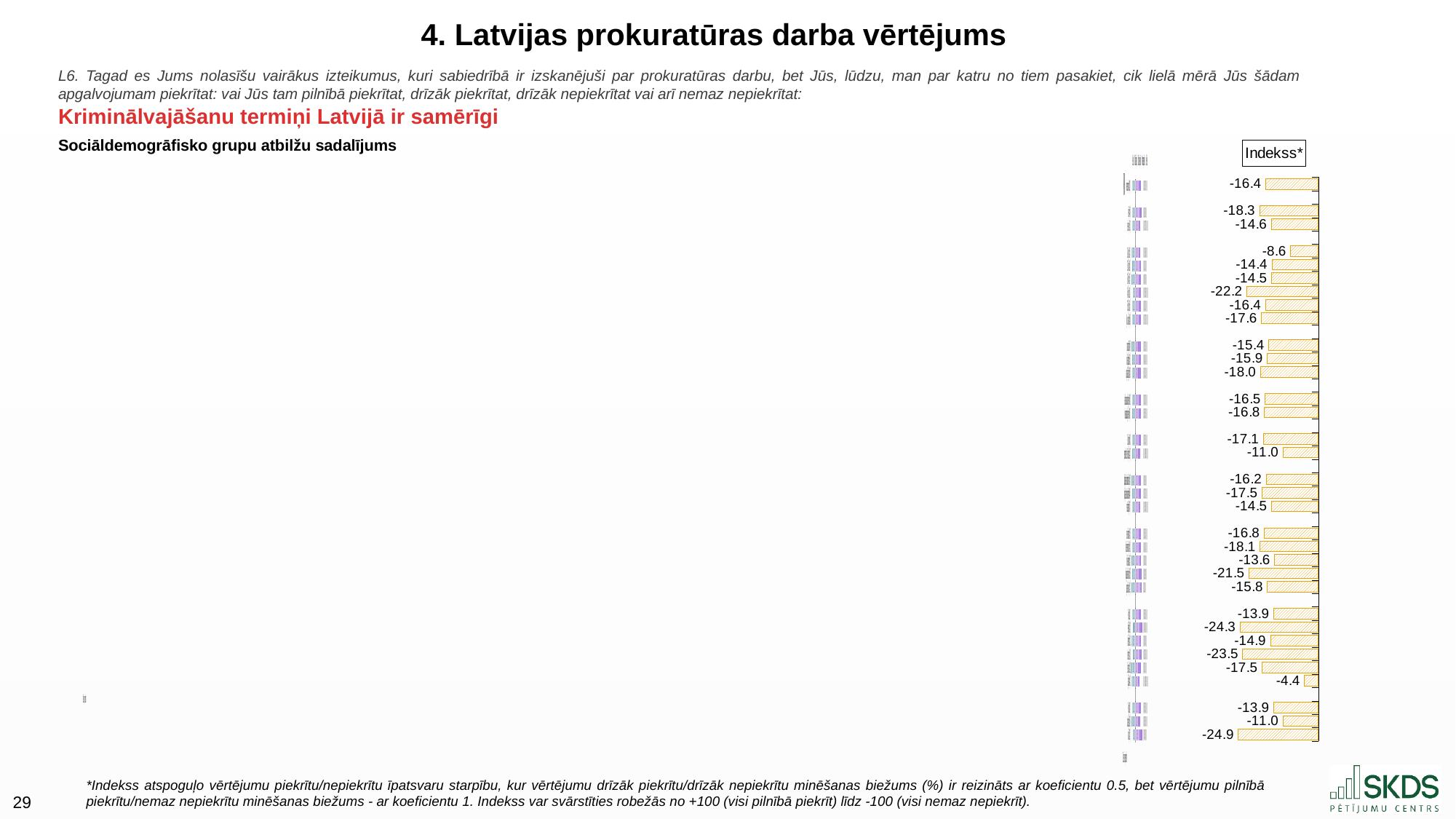
In the Indekss* chart, what is the value of the topmost bar? -16.4 In the Indekss* chart, what is the value of the bottommost bar? -24.9 In the Indekss* chart, which is larger: the value of the topmost bar (-16.4) or the value of the bottommost bar (-24.9)? the topmost bar (-16.4) In the Indekss* chart, what is the highest (least negative) value shown? -4.4 What is the title shown above the chart on the right side of the slide? Indekss* In the Indekss* chart, what is the lowest (most negative) value shown? -24.9 In the Indekss* chart, what is the difference between the highest value (-4.4) and the lowest value (-24.9)? 20.5 What kind of chart is the Indekss* chart on the right side of the slide? bar chart In the Indekss* chart, is the value of the bottommost bar greater or less than -20? less In the Indekss* chart, are all the plotted index values greater or less than 0? less How many bars with data labels are shown in the Indekss* chart? 33